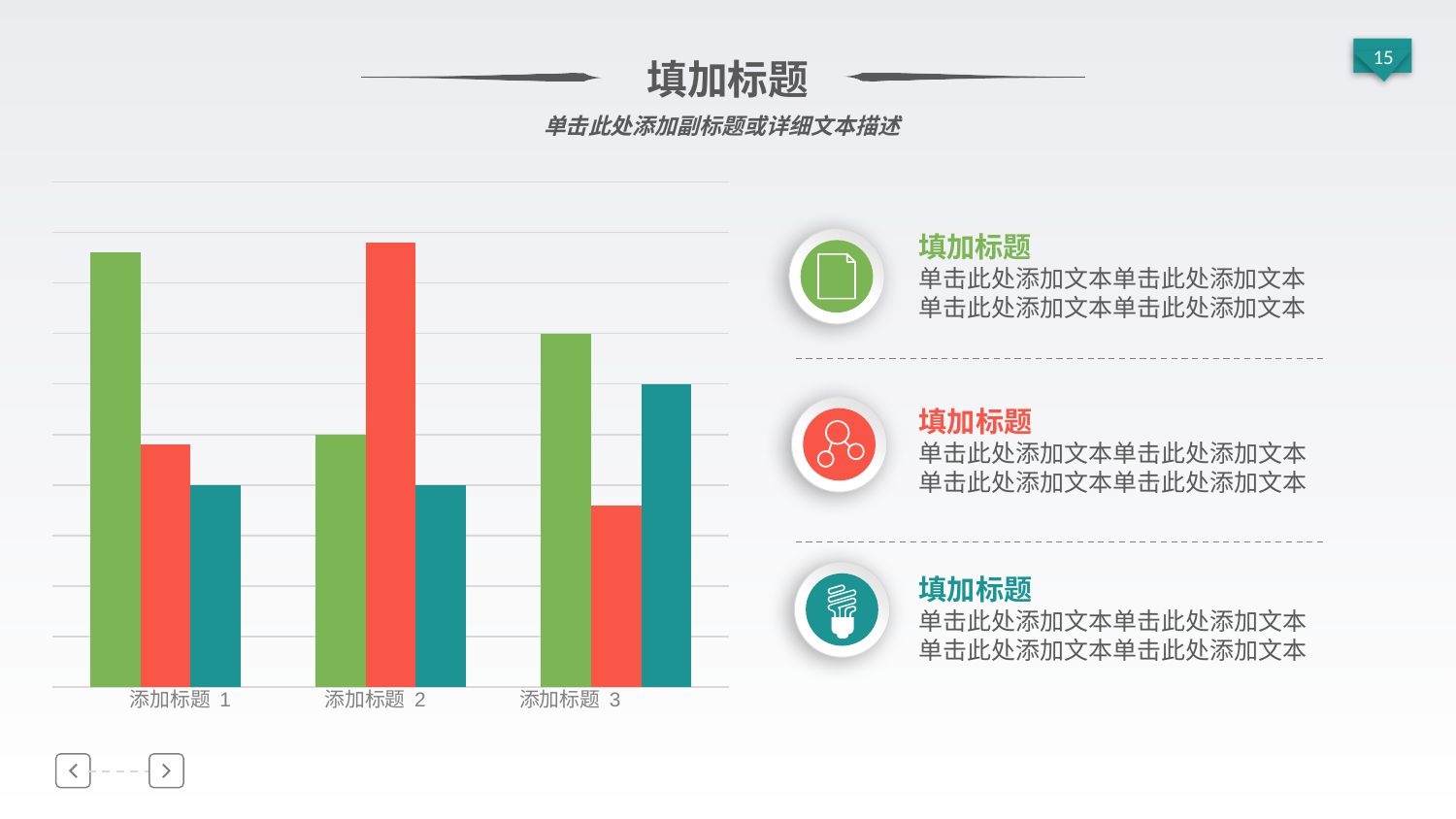
How many bars are plotted for each category in the chart? 3 Does the red bar rise or fall from 添加标题 2 to 添加标题 3? fall What kind of chart is shown on the slide? bar chart How many categories are shown on the x axis of the chart? 3 Is the green bar larger for 添加标题 1 or for 添加标题 2? 添加标题 1 Is the red bar larger for 添加标题 2 or for 添加标题 3? 添加标题 2 What three colours are used for the bars in the chart? green, red and teal Which category has the tallest bar overall in the chart? 添加标题 2 Is the teal bar larger for 添加标题 3 or for 添加标题 1? 添加标题 3 Which bar is the shortest within the 添加标题 3 category? the red bar Which bar is the tallest within the 添加标题 1 category? the green bar Which bar is the shortest within the 添加标题 2 category? the teal bar